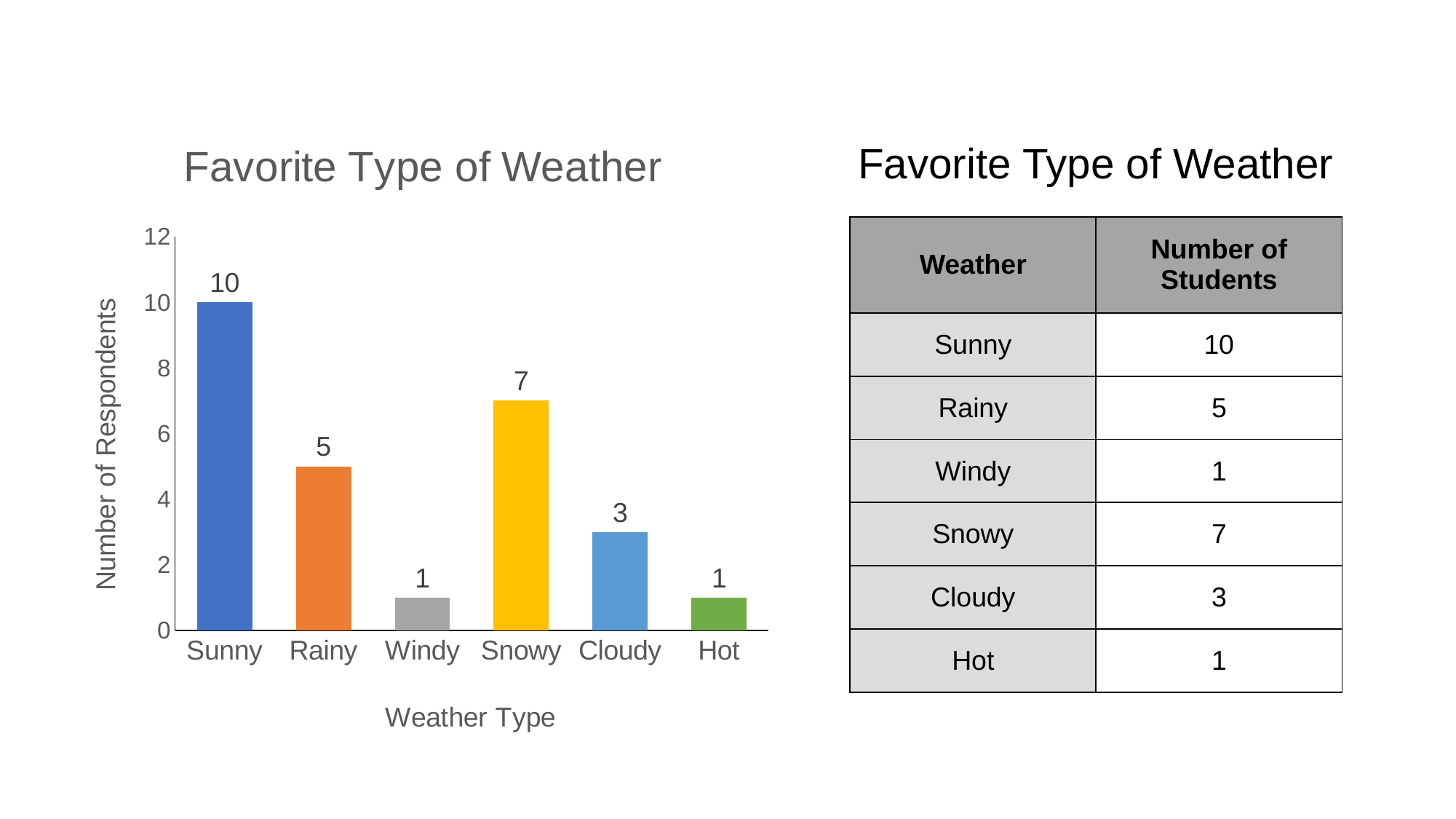
How many weather types are shown on the x axis of the chart? 6 Which is larger in the chart, the value for Rainy or the value for Snowy? Snowy What is the difference between the values for Sunny and Rainy in the chart? 5 What is the value for Sunny in the Favorite Type of Weather chart? 10 Which weather type has the highest number of respondents in the chart? Sunny What is the value for Snowy in the Favorite Type of Weather chart? 7 What is the value for Cloudy in the Favorite Type of Weather chart? 3 Is the value for Sunny in the chart greater or less than 8? greater What is the title of the chart on the slide? Favorite Type of Weather What is the label of the y axis of the chart? Number of Respondents What kind of chart is shown on the slide? Bar chart What is the difference between the values for Snowy and Cloudy in the chart? 4